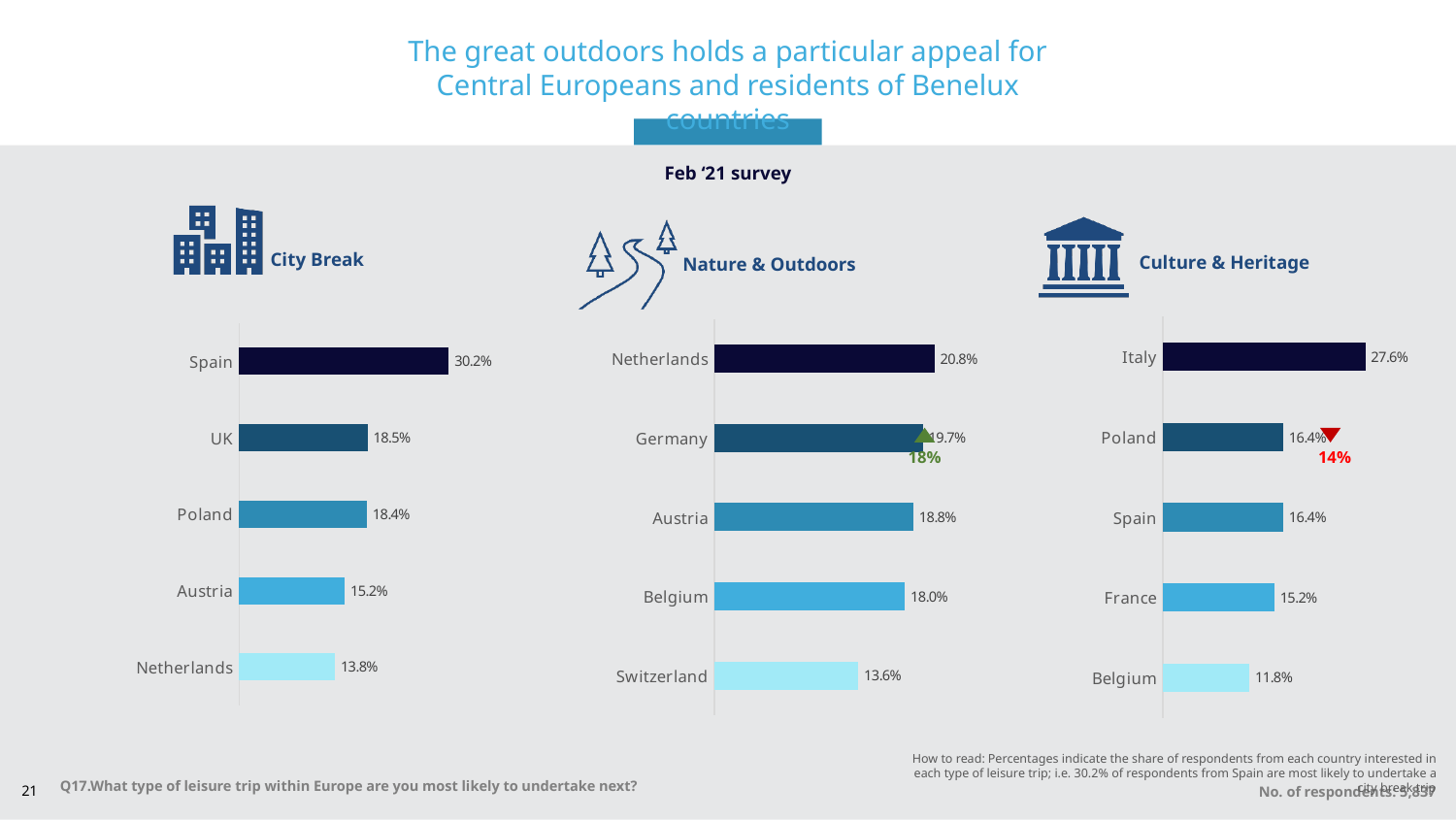
In the Nature & Outdoors chart, which country has the highest value? Netherlands In the City Break chart, what is the difference between the values for Spain and Austria? 15.0% In the Culture & Heritage chart, what is the difference between the values for Italy and Belgium? 15.8% In the Nature & Outdoors chart, what is the value for Belgium? 18.0% In the Culture & Heritage chart, which country has the lowest value? Belgium In the Nature & Outdoors chart, which is larger, the value for Austria or the value for Switzerland? Austria How many countries are shown in the Nature & Outdoors chart? 5 In the City Break chart, what percentage of respondents from Spain are most likely to undertake a city break trip next? 30.2% What type of chart is used for the City Break data? Bar chart How many separate charts are shown on the slide? 3 In the City Break chart, which country has the lowest value? Netherlands In the Culture & Heritage chart, what is the value for France? 15.2%